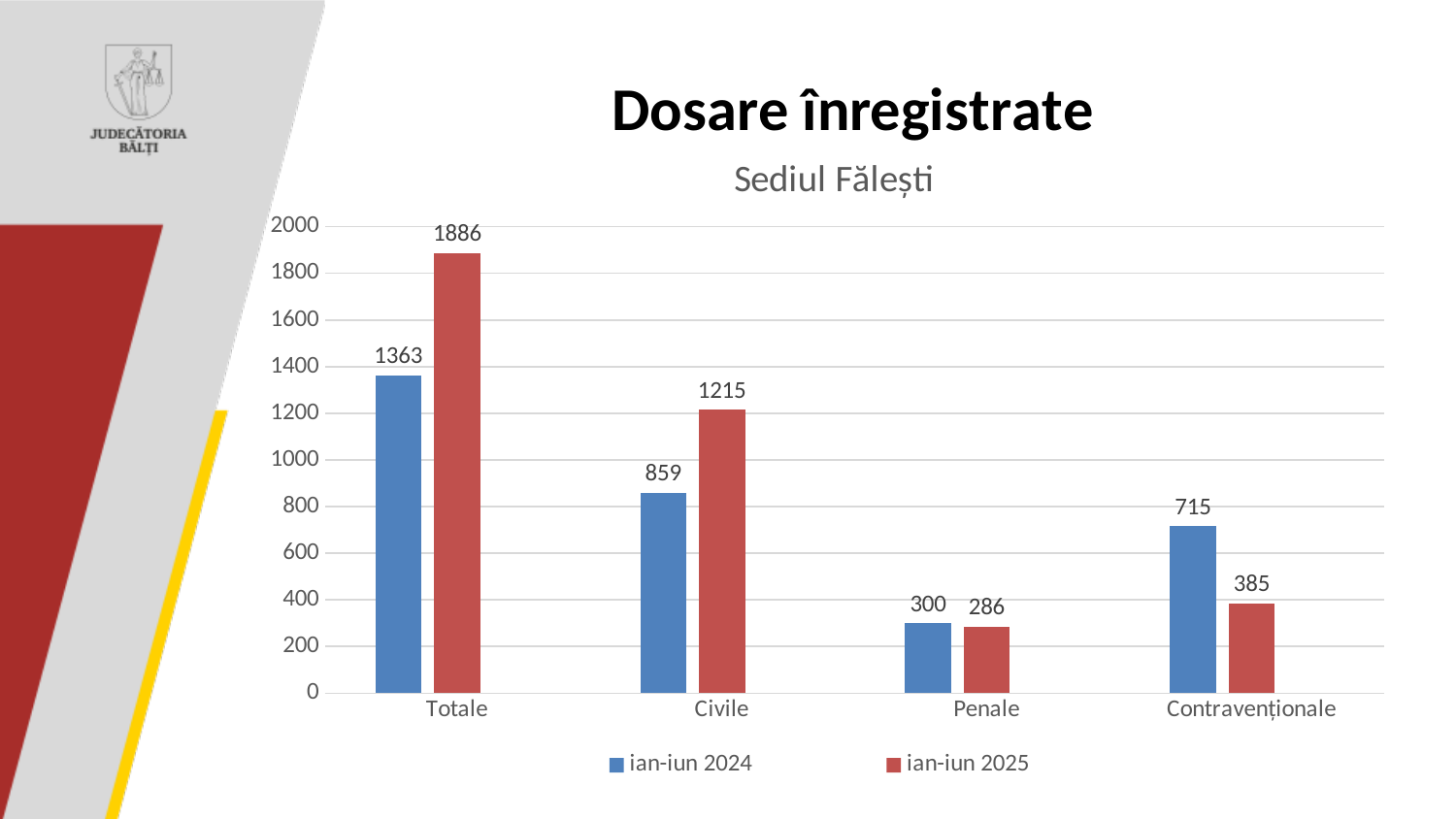
What is the value for Penale in the ian-iun 2025 series? 286 What kind of chart is shown on the slide? Bar chart What is the value for Civile in the ian-iun 2025 series? 1215 How many categories are shown on the x axis? 4 Which category has the highest value in the ian-iun 2024 series? Totale What is the difference between the ian-iun 2025 and ian-iun 2024 values for Totale? 523 What is the subtitle shown below the chart title 'Dosare înregistrate'? Sediul Fălești Which category has the lowest value in the ian-iun 2025 series? Penale What is the value for Contravenționale in the ian-iun 2024 series? 715 What is the difference between the ian-iun 2024 and ian-iun 2025 values for Contravenționale? 330 How many series does the legend list? 2 Which is larger for Civile: the ian-iun 2024 value or the ian-iun 2025 value? ian-iun 2025